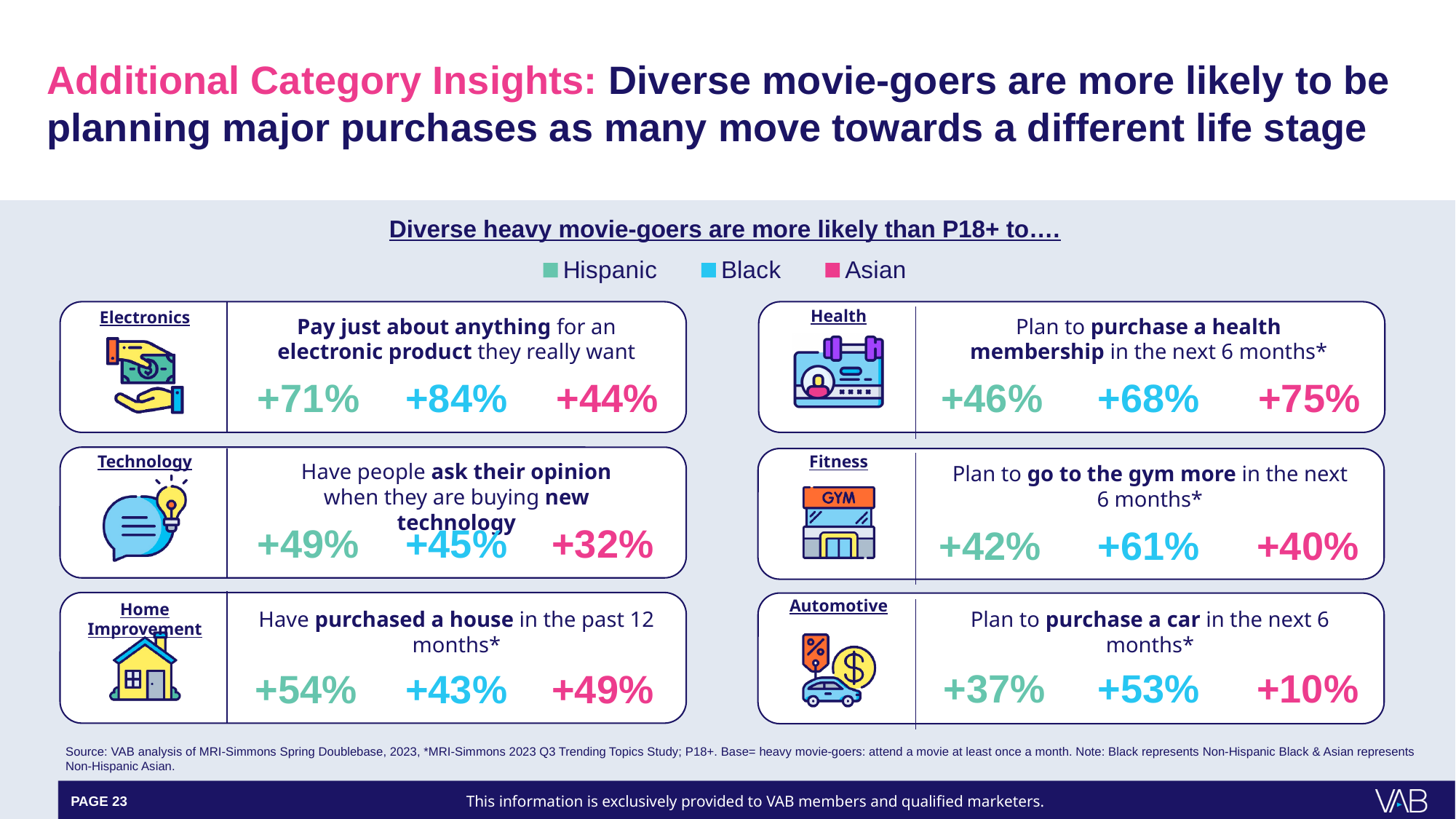
What is the value for Asian in the Health category (plan to purchase a health membership in the next 6 months)? +75% Which colour represents Asian in the legend? Pink In the Home Improvement category, which is larger: the Hispanic value or the Black value? Hispanic What is the difference between the Black and Hispanic values in the Electronics category? 13% What is the difference between the Asian and Hispanic values in the Health category? 29% In the Technology category (have people ask their opinion when buying new technology), which group has the lowest value? Asian How many groups does the legend list? 3 In the Fitness category (plan to go to the gym more), which group has the highest value? Black What is the value for Asian in the Automotive category (plan to purchase a car in the next 6 months)? +10% What is the value for Hispanic in the Home Improvement category (have purchased a house in the past 12 months)? +54% How many purchase categories are shown on the slide? 6 What is the value for Black in the Electronics category (pay just about anything for an electronic product)? +84%